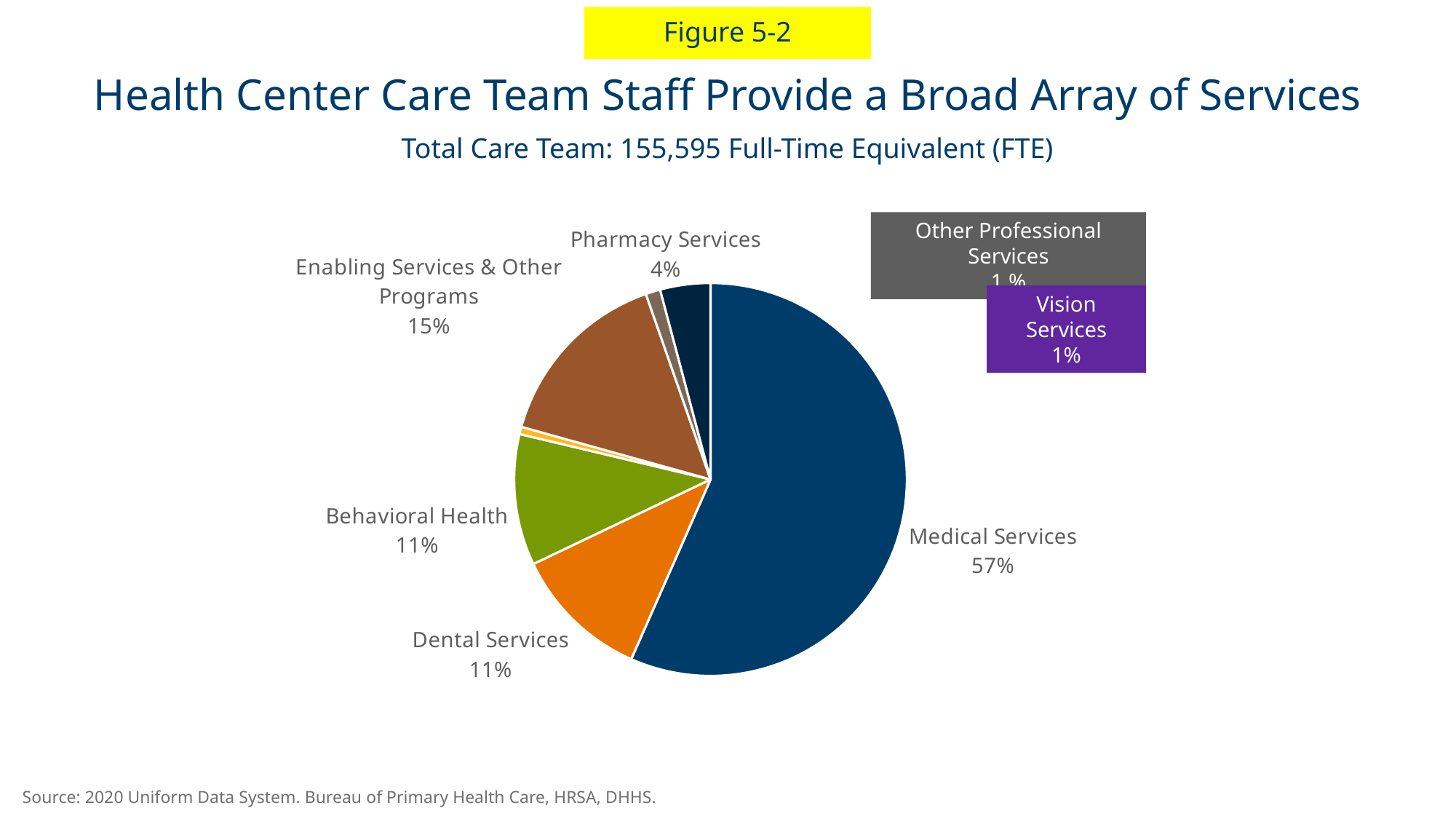
What is the total care team size stated in the chart subtitle? 155,595 Full-Time Equivalent (FTE) What kind of chart is shown on the slide? pie chart What share of the care team is Enabling Services & Other Programs? 15% What share of the care team is Pharmacy Services? 4% What is the difference in percentage points between Medical Services and Dental Services? 46 What is the difference in percentage points between Enabling Services & Other Programs and Pharmacy Services? 11 How many slices does the pie chart have? 7 What share of the care team is Vision Services? 1% What share of the care team is Dental Services? 11% Which is larger, Enabling Services & Other Programs or Behavioral Health? Enabling Services & Other Programs Which category has the largest share of the pie? Medical Services What share of the care team is Medical Services? 57%